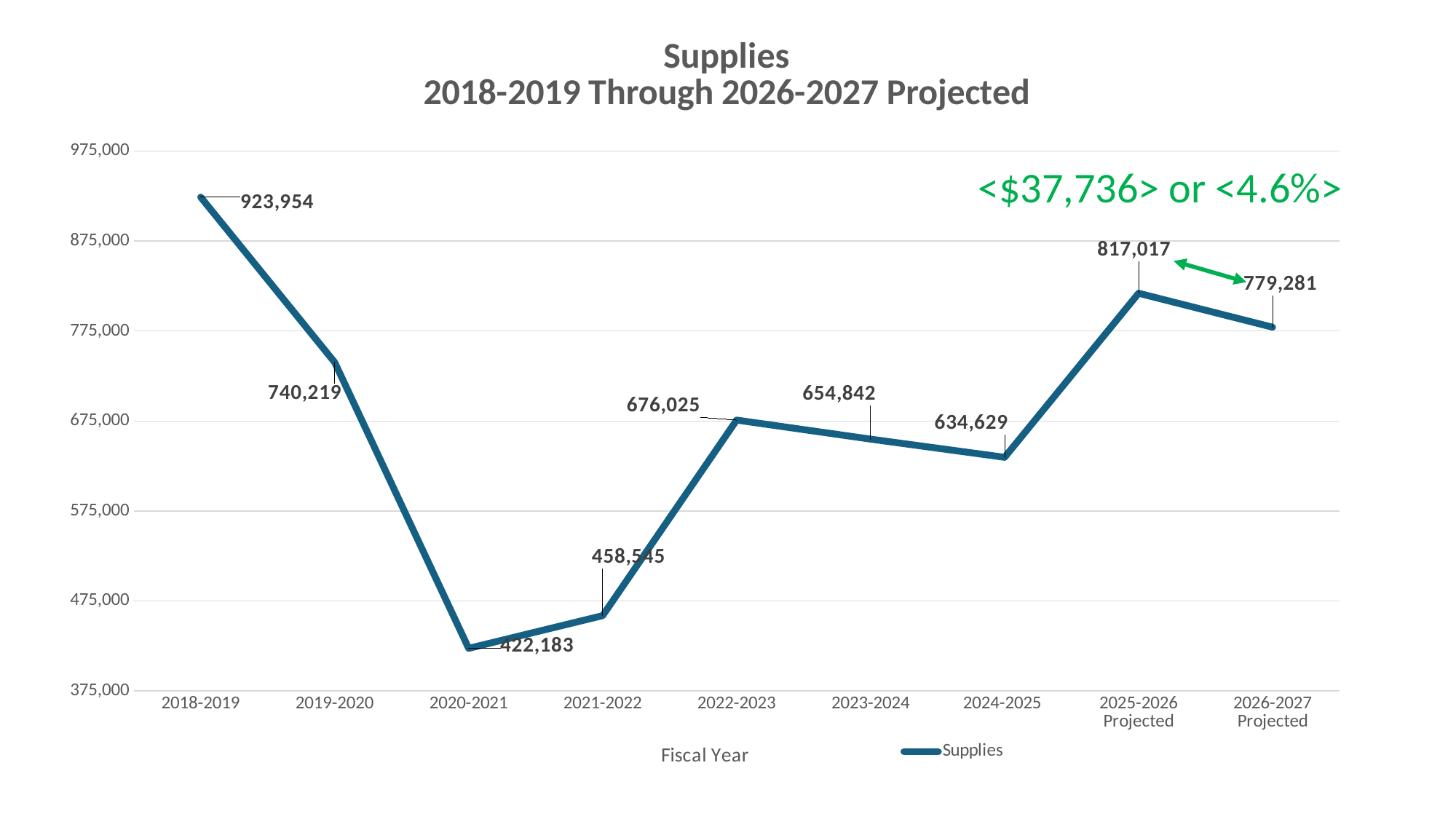
How many series does the legend list? 1 What kind of chart is shown on the slide? line chart Which is larger, the Supplies value for 2022-2023 or for 2023-2024? 2022-2023 Is the Supplies value for 2021-2022 greater or less than 475,000? less What is the projected Supplies value for 2026-2027? 779,281 Does the Supplies value rise or fall from 2024-2025 to 2025-2026 Projected? rise What is the Supplies value for 2018-2019? 923,954 How many fiscal years are plotted on the chart? 9 Which fiscal year has the lowest Supplies value? 2020-2021 Which fiscal year has the highest Supplies value? 2018-2019 What is the Supplies value for 2020-2021? 422,183 What is the difference between the 2025-2026 Projected and 2026-2027 Projected Supplies values? 37,736